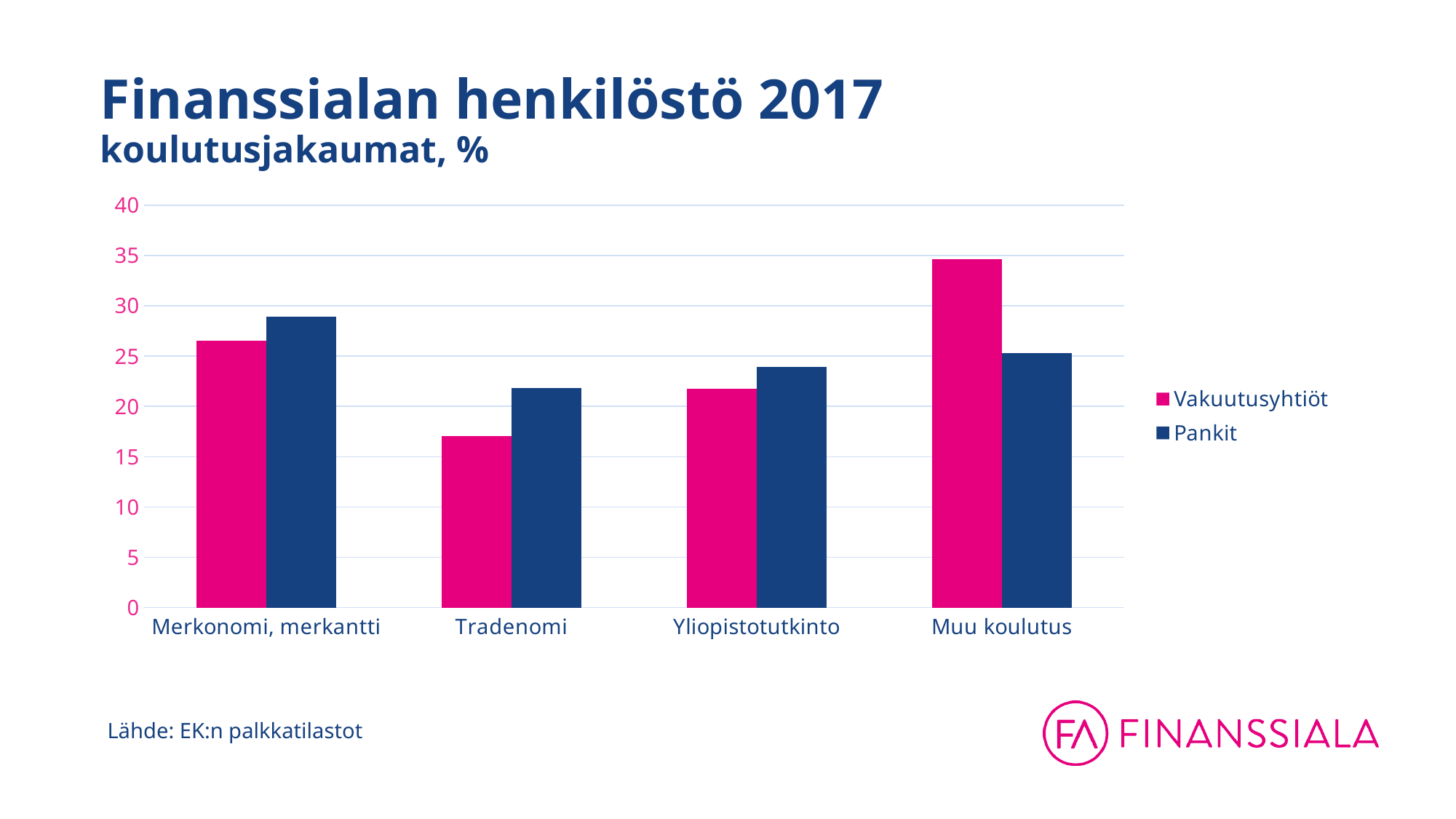
How many series does the legend list? 2 Which category has the lowest value for Pankit? Tradenomi What is the title of the chart on the slide? Finanssialan henkilöstö 2017 koulutusjakaumat, % Which category has the highest value for Vakuutusyhtiöt? Muu koulutus How many education categories are shown on the x axis? 4 For Muu koulutus, which series has the larger value, Vakuutusyhtiöt or Pankit? Vakuutusyhtiöt Which category has the lowest value for Vakuutusyhtiöt? Tradenomi Is the value for Vakuutusyhtiöt in Tradenomi greater or less than 20? less For Tradenomi, which series has the larger value, Vakuutusyhtiöt or Pankit? Pankit What kind of chart is shown on the slide? Bar chart Which category has the highest value for Pankit? Merkonomi, merkantti Is the value for Vakuutusyhtiöt in Muu koulutus greater or less than 30? greater